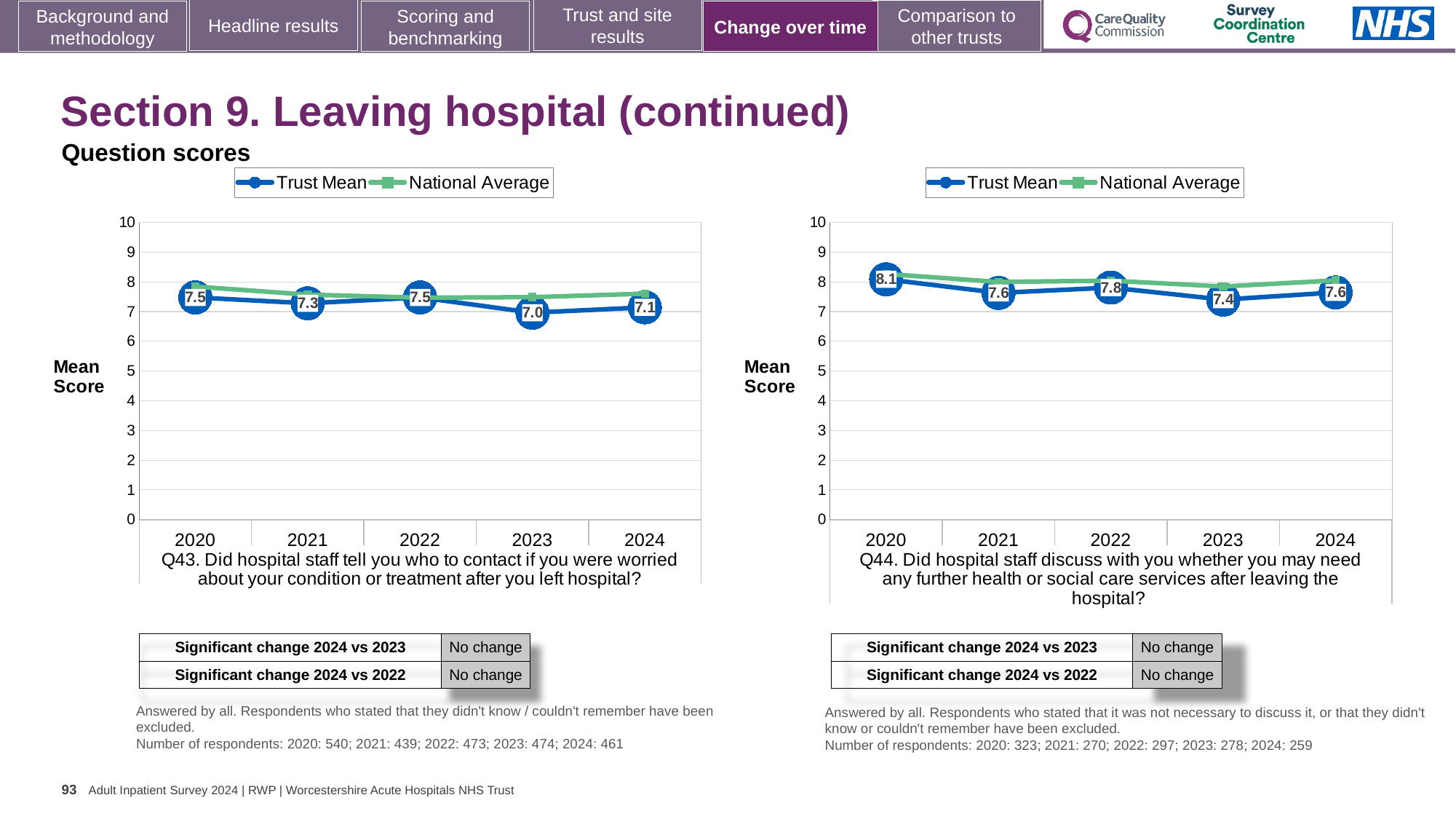
What type of chart is used for Q43 (left)? Line chart In the Q44 chart (right), what is the Trust Mean score for 2020? 8.1 In the Q43 chart (left), what is the Trust Mean score for 2023? 7.0 How many years are plotted on the x axis of the Q43 chart (left)? 5 In the Q44 chart (right), did the Trust Mean score rise or fall from 2020 to 2021? Fall In the Q44 chart (right), what is the difference between the Trust Mean scores for 2020 and 2023? 0.7 In the Q43 chart (left), what is the difference between the Trust Mean scores for 2022 and 2024? 0.4 In the Q43 chart (left), which year has the lowest Trust Mean score? 2023 In the Q44 chart (right), which year has the highest Trust Mean score? 2020 How many series does the legend of the Q44 chart (right) list? 2 In the Q43 chart (left), is the Trust Mean score higher in 2021 or in 2024? 2021 In the Q44 chart (right), is the National Average value for 2020 greater or less than 7? greater